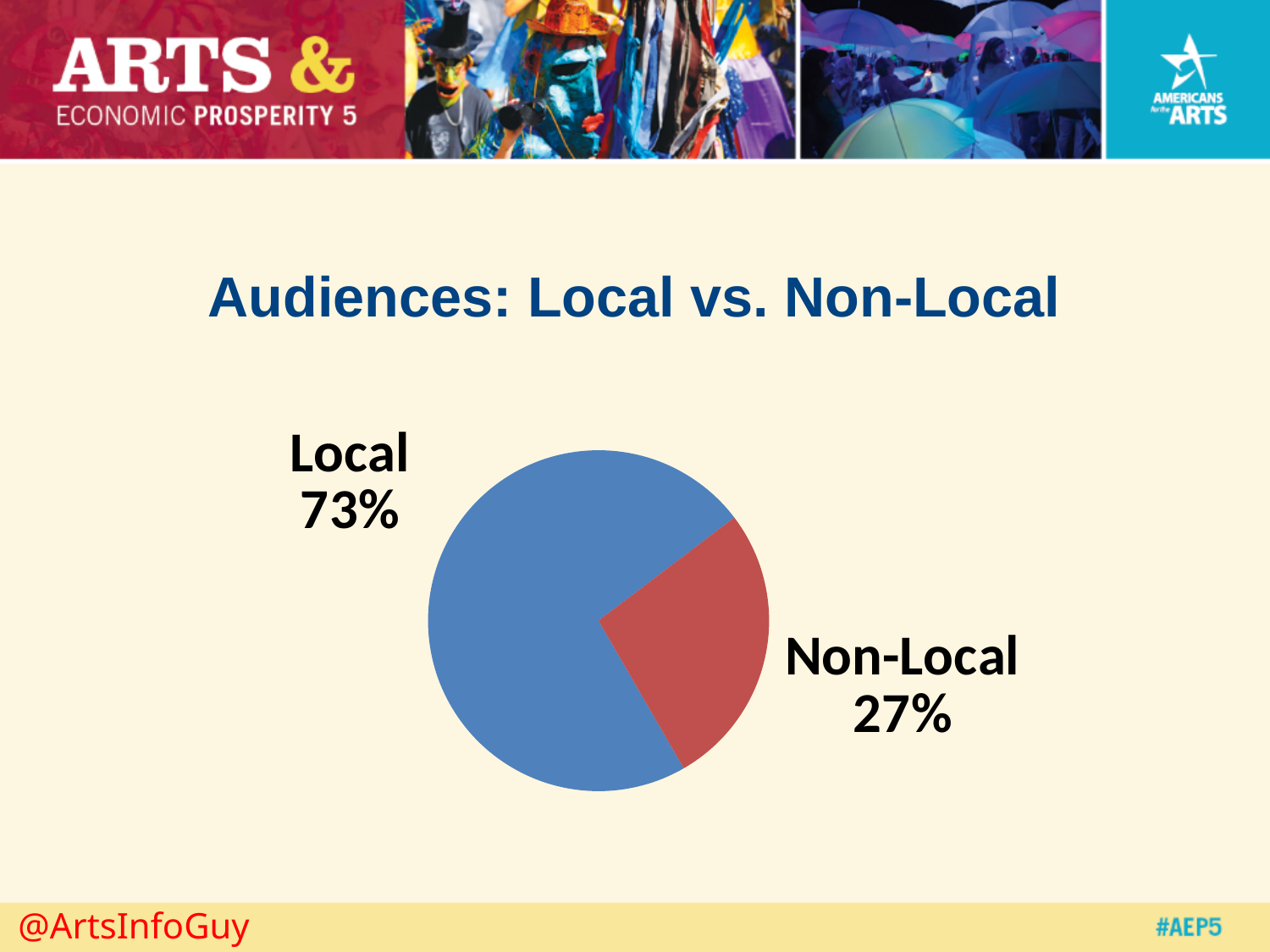
What colour is the Non-Local slice? Red What is the title of the chart? Audiences: Local vs. Non-Local What share of audiences is Non-Local? 27% How many slices does the pie chart have? 2 What is the difference in percentage points between the Local and Non-Local shares? 46 Which category has the smallest share of the pie? Non-Local Which category has the largest share of the pie? Local What is the total of the two slices shown? 100% What kind of chart is shown on the slide? Pie chart What share of audiences is Local? 73% Which is larger, the Local share or the Non-Local share? Local